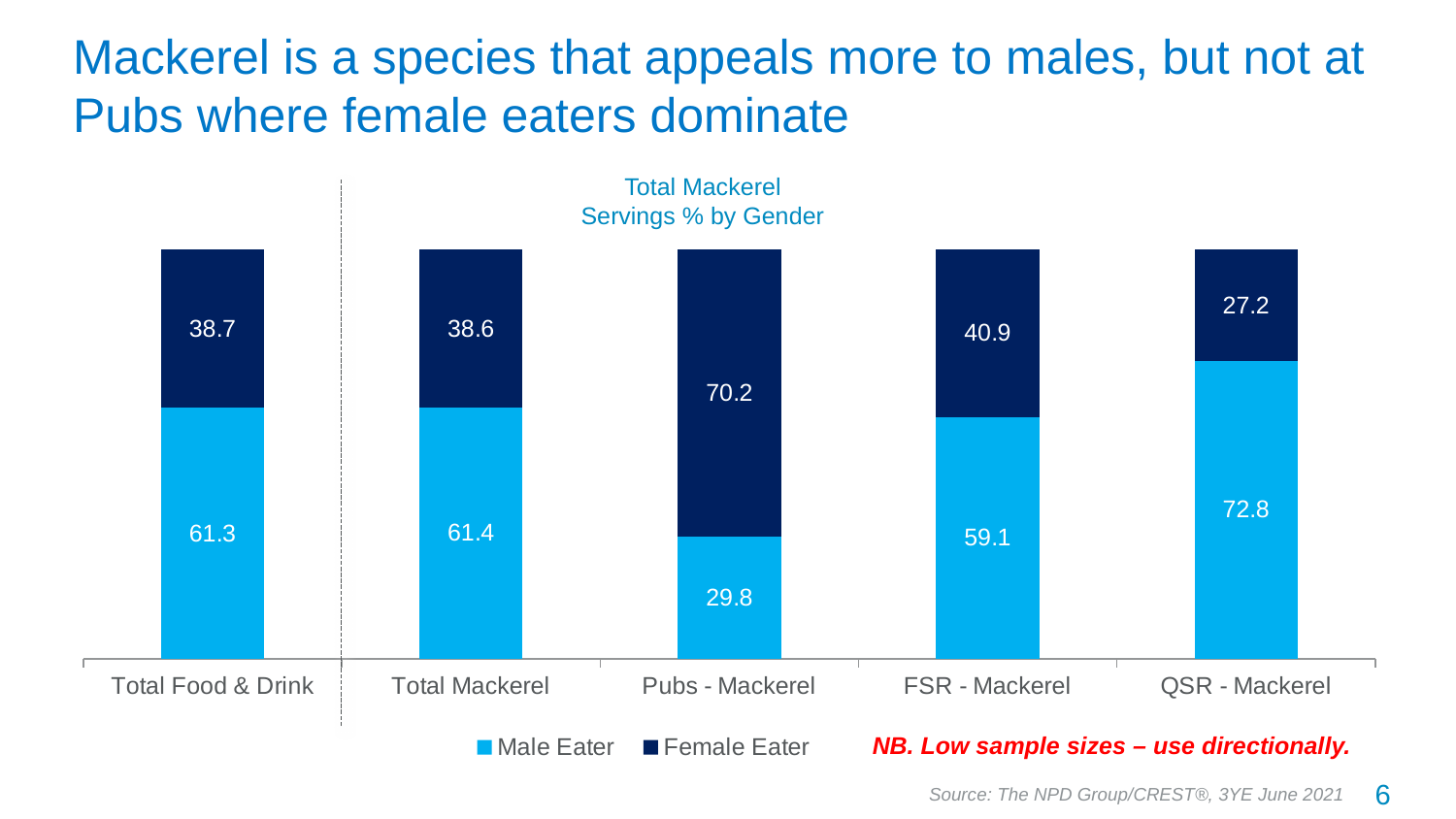
How many series does the legend list? 2 What is the title of the chart? Total Mackerel Servings % by Gender Which category has the lowest Male Eater value? Pubs - Mackerel What is the Male Eater value for Total Food & Drink? 61.3 Which is larger: the Male Eater value for QSR - Mackerel or the Male Eater value for FSR - Mackerel? QSR - Mackerel How many categories are shown on the x axis? 5 What kind of chart is shown on the slide? Stacked bar chart What is the difference between the Male Eater and Female Eater values for Pubs - Mackerel? 40.4 What is the Male Eater value for Pubs - Mackerel? 29.8 Which category has the highest Female Eater value? Pubs - Mackerel What is the Female Eater value for QSR - Mackerel? 27.2 What is the Female Eater value for FSR - Mackerel? 40.9